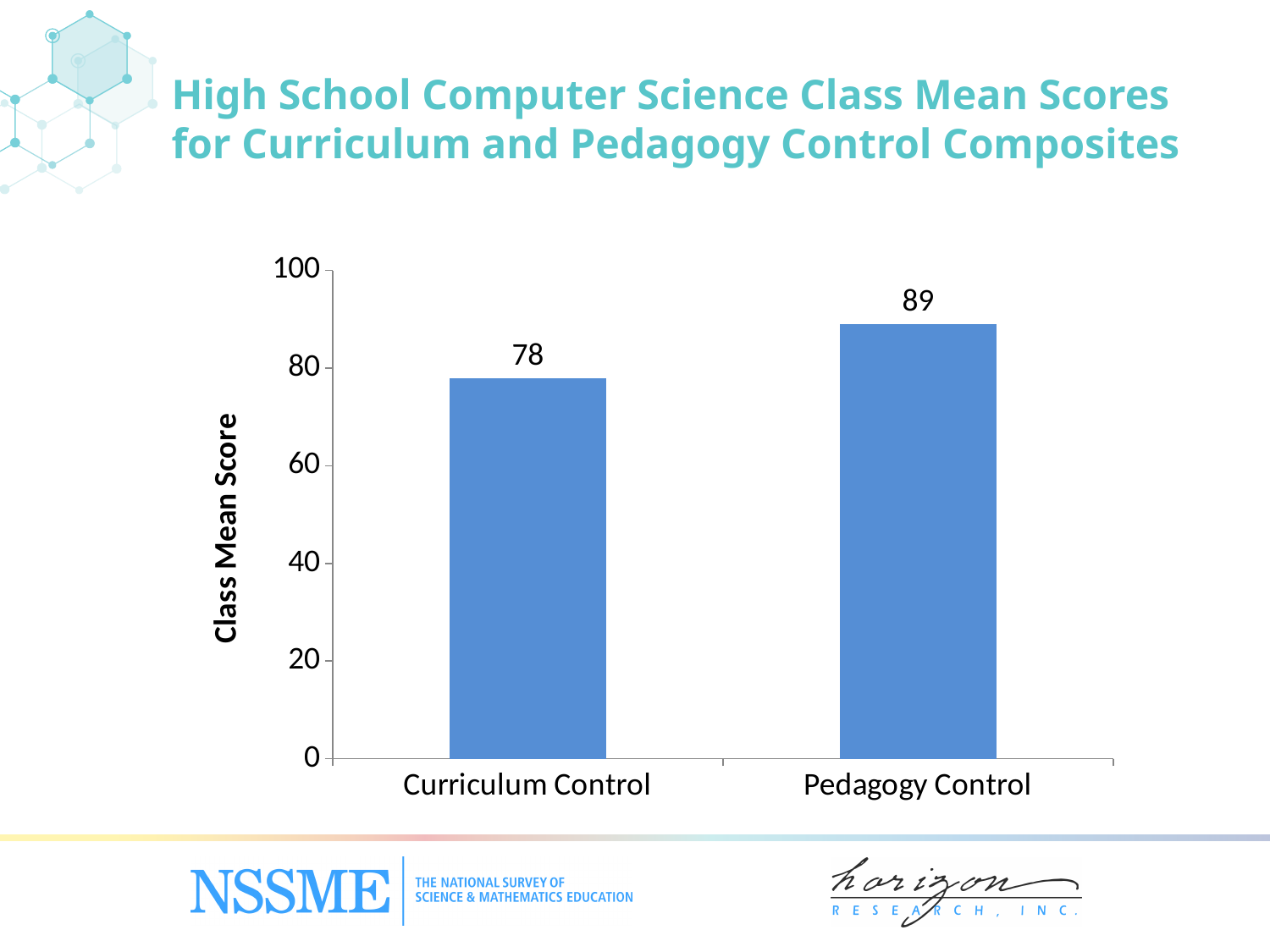
What is the label of the y axis? Class Mean Score Which is larger, the class mean score for Curriculum Control or for Pedagogy Control? Pedagogy Control Which category has the lowest class mean score? Curriculum Control Is the class mean score for Pedagogy Control greater or less than 80? greater Is the class mean score for Curriculum Control greater or less than 80? less How many categories are shown on the x axis? 2 Which category has the highest class mean score? Pedagogy Control What is the maximum value shown on the y axis? 100 What is the class mean score for Pedagogy Control? 89 What kind of chart is shown on the slide? bar chart What is the class mean score for Curriculum Control? 78 What is the difference between the class mean scores for Pedagogy Control and Curriculum Control? 11